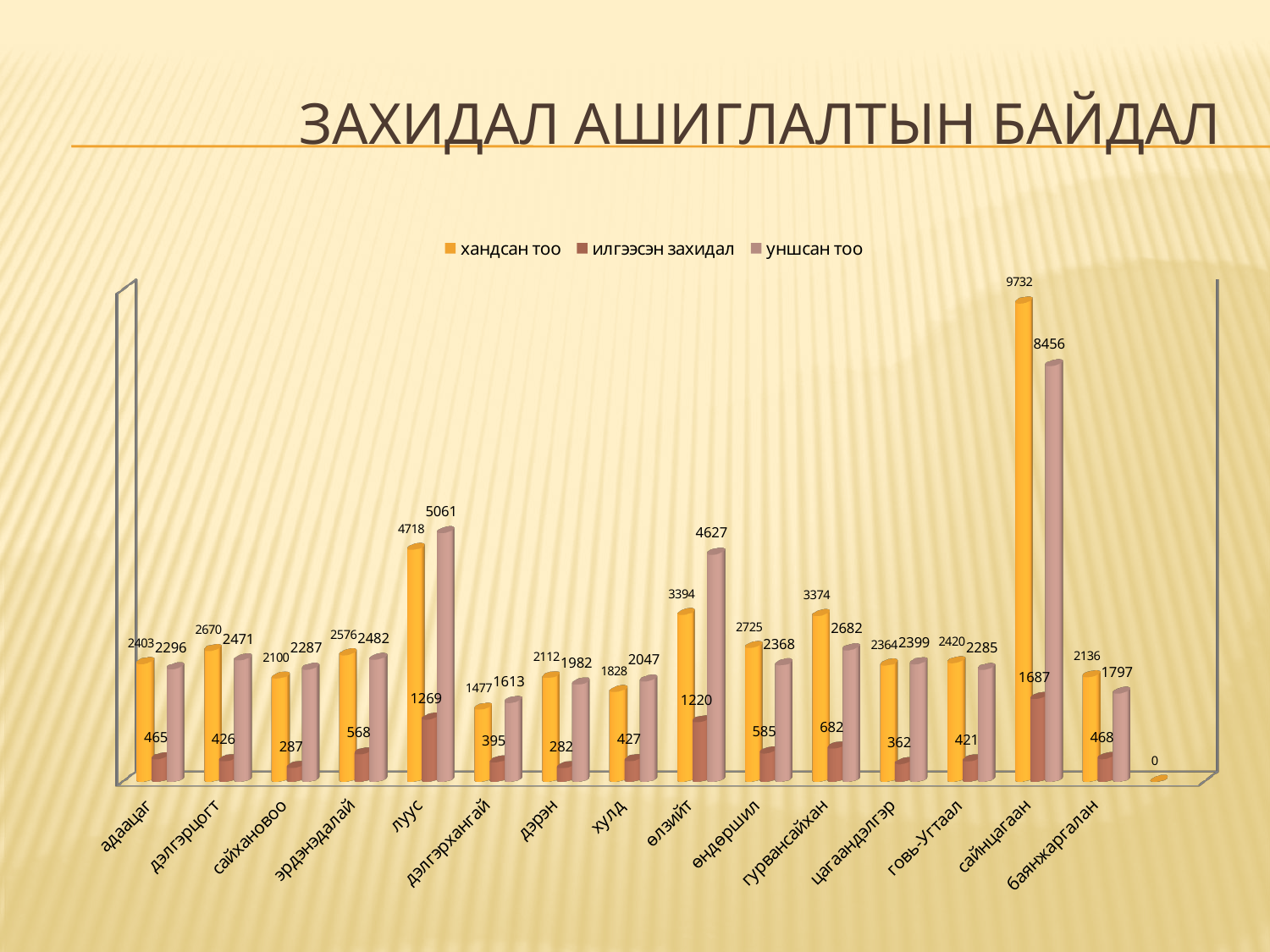
What is the difference between хандсан тоо and илгээсэн захидал for гурвансайхан? 2692 What kind of chart is shown on the slide? bar chart Which category has the highest хандсан тоо value? сайнцагаан How many series does the legend list? 3 What is the value of илгээсэн захидал for луус? 1269 What is the value of илгээсэн захидал for дэрэн? 282 What is the title of the slide? ЗАХИДАЛ АШИГЛАЛТЫН БАЙДАЛ Which is larger for луус: хандсан тоо or уншсан тоо? уншсан тоо What is the value of хандсан тоо for сайнцагаан? 9732 Which labeled category has the lowest хандсан тоо value? дэлгэрхангай What is the value of уншсан тоо for өлзийт? 4627 What is the difference between хандсан тоо and уншсан тоо for сайнцагаан? 1276